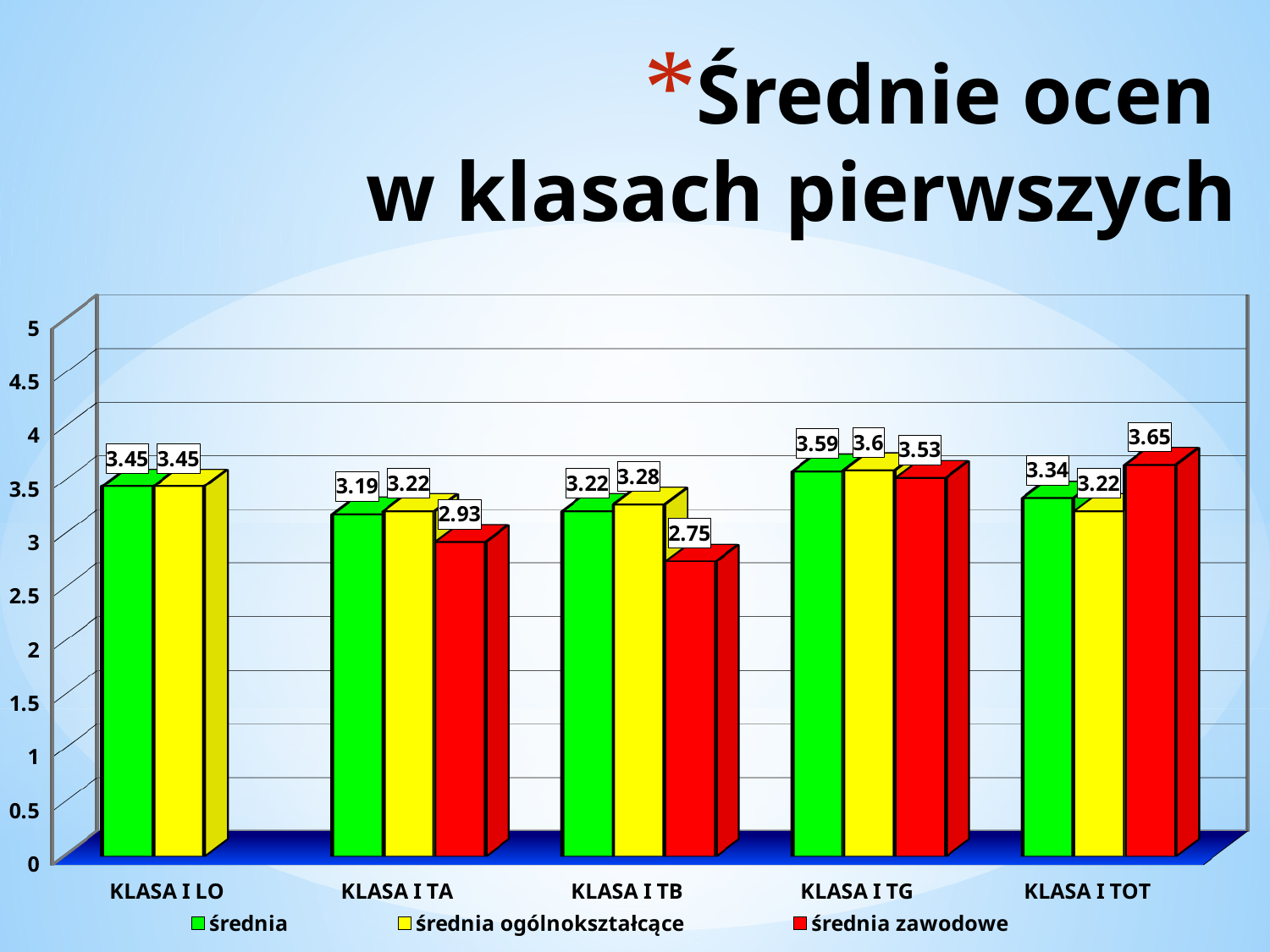
What kind of chart is shown on the slide? bar chart Which series is shown in red? średnia zawodowe Which is larger: "średnia ogólnokształcące" for KLASA I TB or for KLASA I TOT? KLASA I TB What is the value of "średnia zawodowe" for KLASA I TB? 2.75 What is the value of "średnia ogólnokształcące" for KLASA I TG? 3.6 How many categories are shown on the x axis? 5 What is the value of "średnia" for KLASA I TOT? 3.34 Which category has the highest value for "średnia zawodowe"? KLASA I TOT Which category has the lowest value for "średnia"? KLASA I TA Is the value of "średnia zawodowe" for KLASA I TA greater or less than 3? less What is the difference between "średnia zawodowe" for KLASA I TOT and for KLASA I TB? 0.9 How many series does the legend list? 3